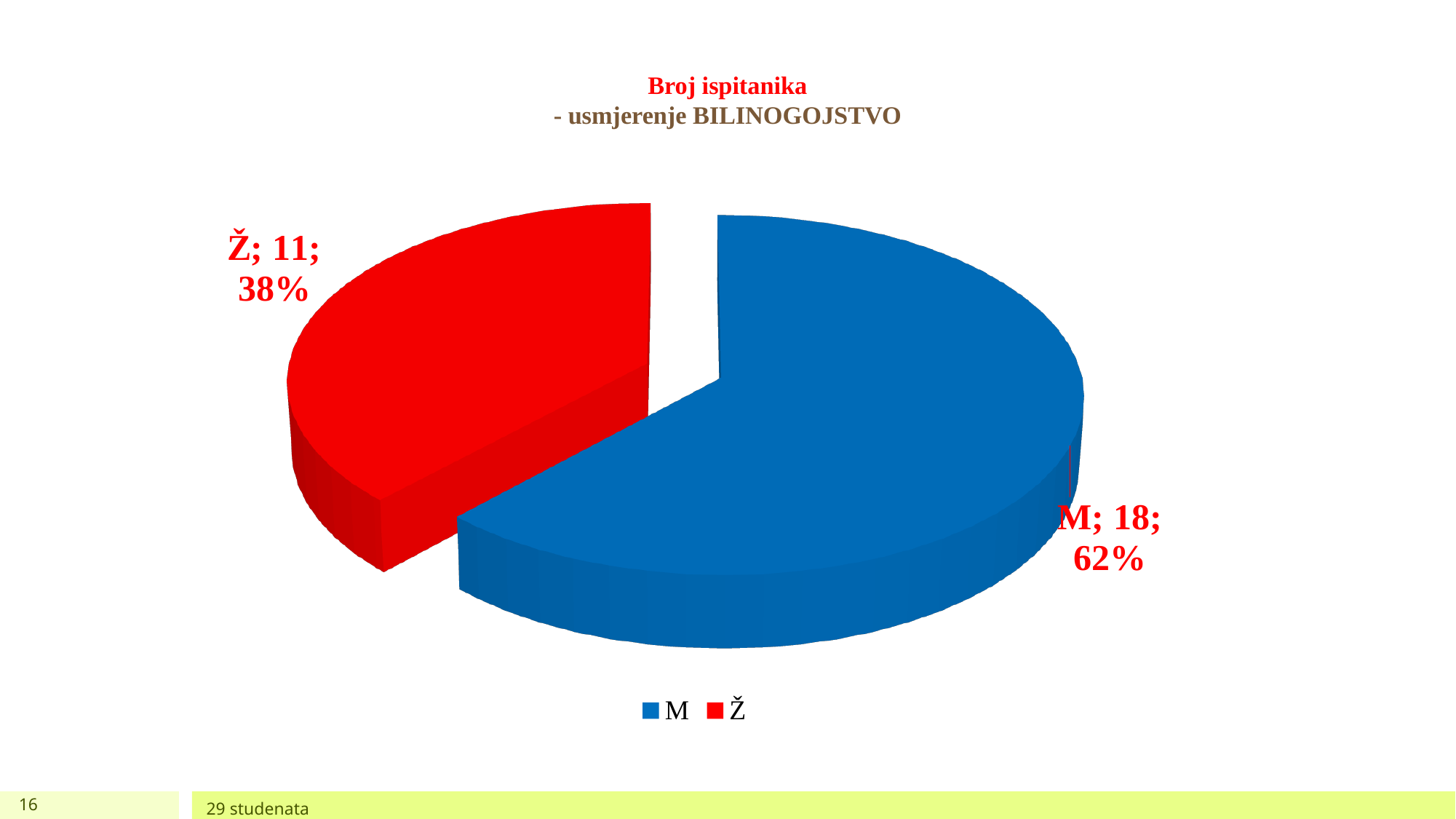
What kind of chart is shown on the slide? pie chart What is the difference between the values for M and Ž? 7 What colour is the slice for Ž? red Which category has the smallest slice? Ž What share of the pie does the Ž slice represent? 38% What is the value for Ž? 11 What share of the pie does the M slice represent? 62% What is the value for M? 18 How many slices does the pie chart have? 2 Which category has the largest slice? M How many entries does the legend list? 2 Which is larger, the value for M or the value for Ž? M